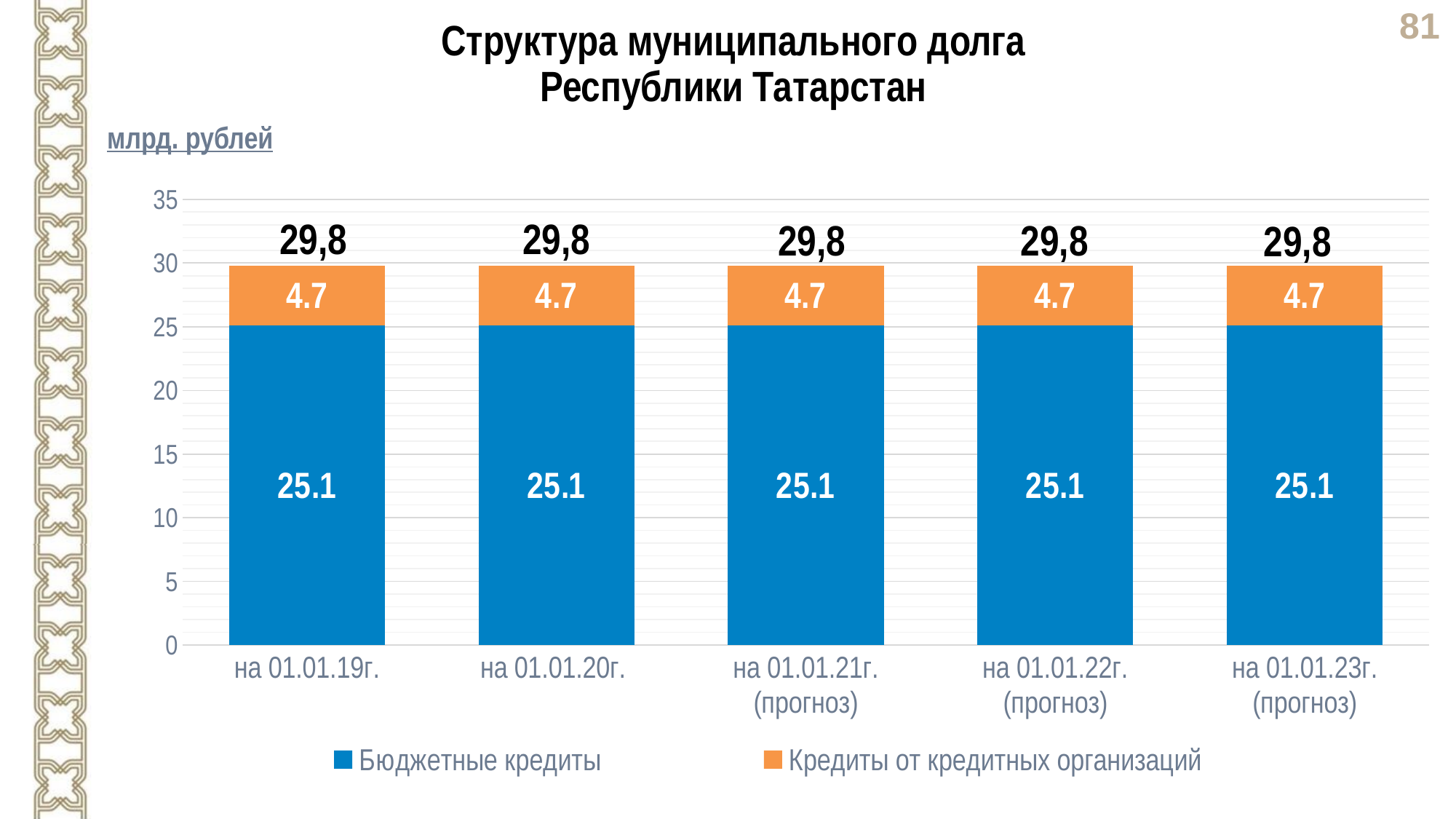
Which is larger for на 01.01.23г. (прогноз): Бюджетные кредиты or Кредиты от кредитных организаций? Бюджетные кредиты What is the title of the chart? Структура муниципального долга Республики Татарстан What unit is indicated for the chart values? млрд. рублей What is the total of the stacked bar for на 01.01.21г. (прогноз)? 29,8 Do the total values rise, fall or stay the same across the x axis? stay the same What is the difference between Бюджетные кредиты and Кредиты от кредитных организаций for на 01.01.20г.? 20.4 What kind of chart is shown on the slide? stacked bar chart How many series does the legend list? 2 How many categories are shown on the x axis? 5 What is the value of Бюджетные кредиты for на 01.01.19г.? 25.1 What is the value of Кредиты от кредитных организаций for на 01.01.22г. (прогноз)? 4.7 Is the value of Бюджетные кредиты for на 01.01.22г. (прогноз) greater or less than 20? greater